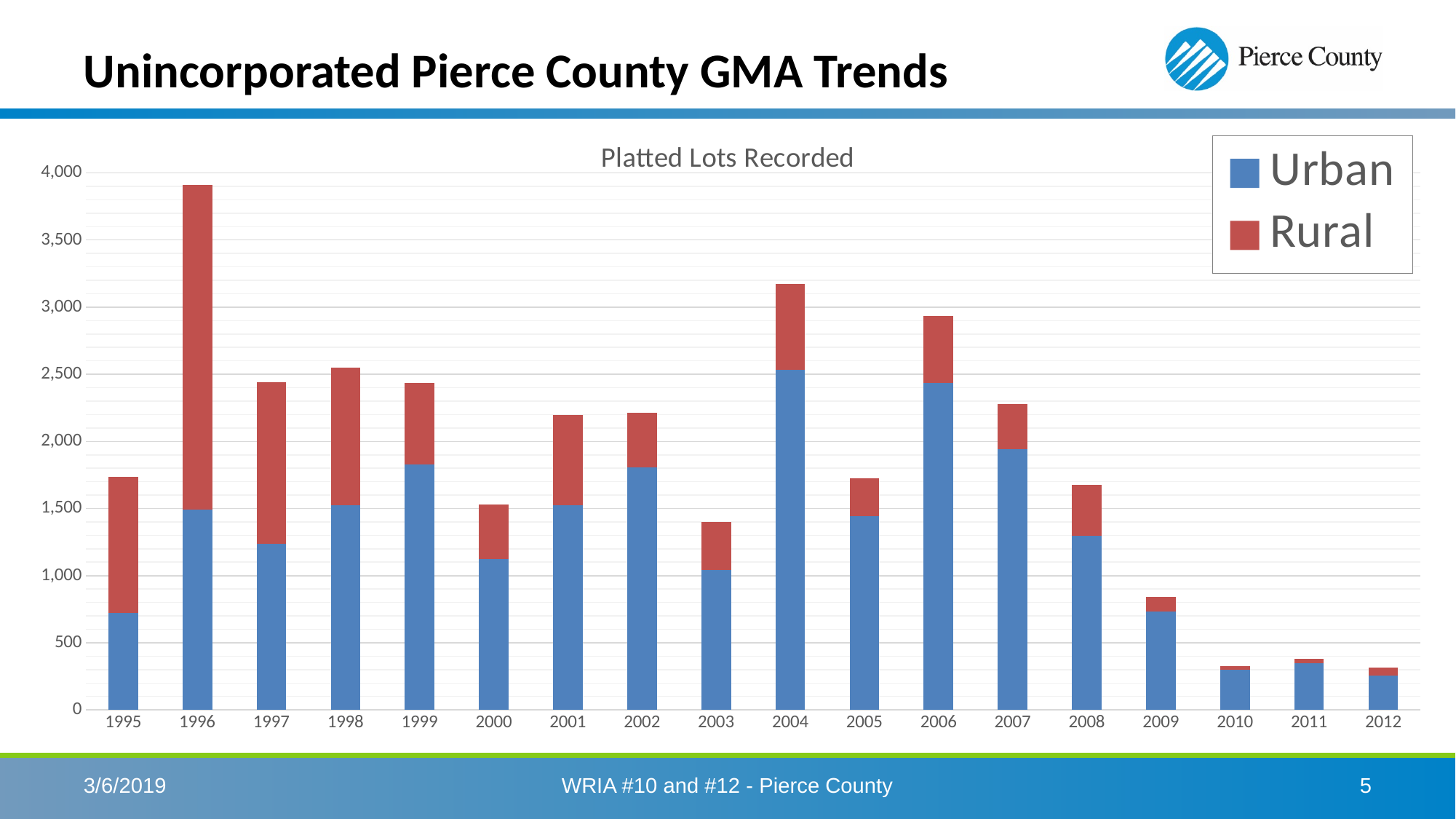
Which year has the larger total, 2007 or 2008? 2007 How many years are shown on the x axis? 18 How many series does the legend list? 2 What is the title of the chart? Platted Lots Recorded What kind of chart is shown on the slide? bar chart Is the total for 2009 greater or less than 1,000? less Is the Urban value for 2003 greater or less than 1,500? less Which year has the largest Rural value? 1996 Is the total for 2004 greater or less than 3,000? greater Do the totals rise or fall from 2006 to 2012? fall Which year has the highest total of platted lots recorded? 1996